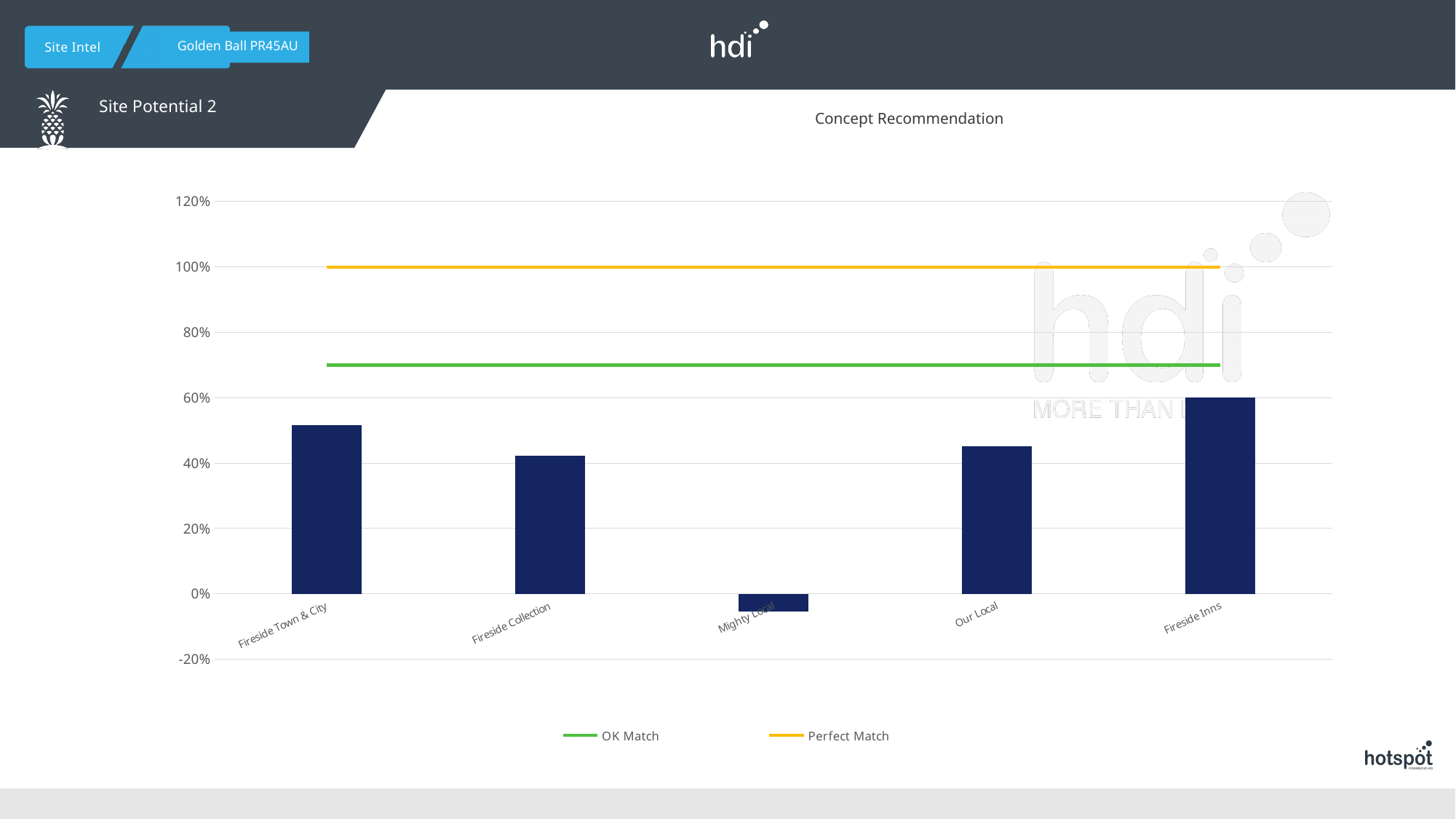
How many concept categories are plotted on the x axis? 5 Is the value for Mighty Local greater or less than 0%? less Which is larger, the bar for Our Local or the bar for Fireside Inns? Fireside Inns At what level is the Perfect Match line drawn? 100% Is the value for Fireside Collection greater or less than 60%? less What kind of chart is shown on the slide? combination bar and line chart Which is larger, the bar for Fireside Town & City or the bar for Fireside Collection? Fireside Town & City Which concept has the highest bar? Fireside Inns How many entries does the legend list? 2 What is the title of the chart? Concept Recommendation Is the value for Fireside Town & City greater or less than 40%? greater Which concept has the lowest bar? Mighty Local